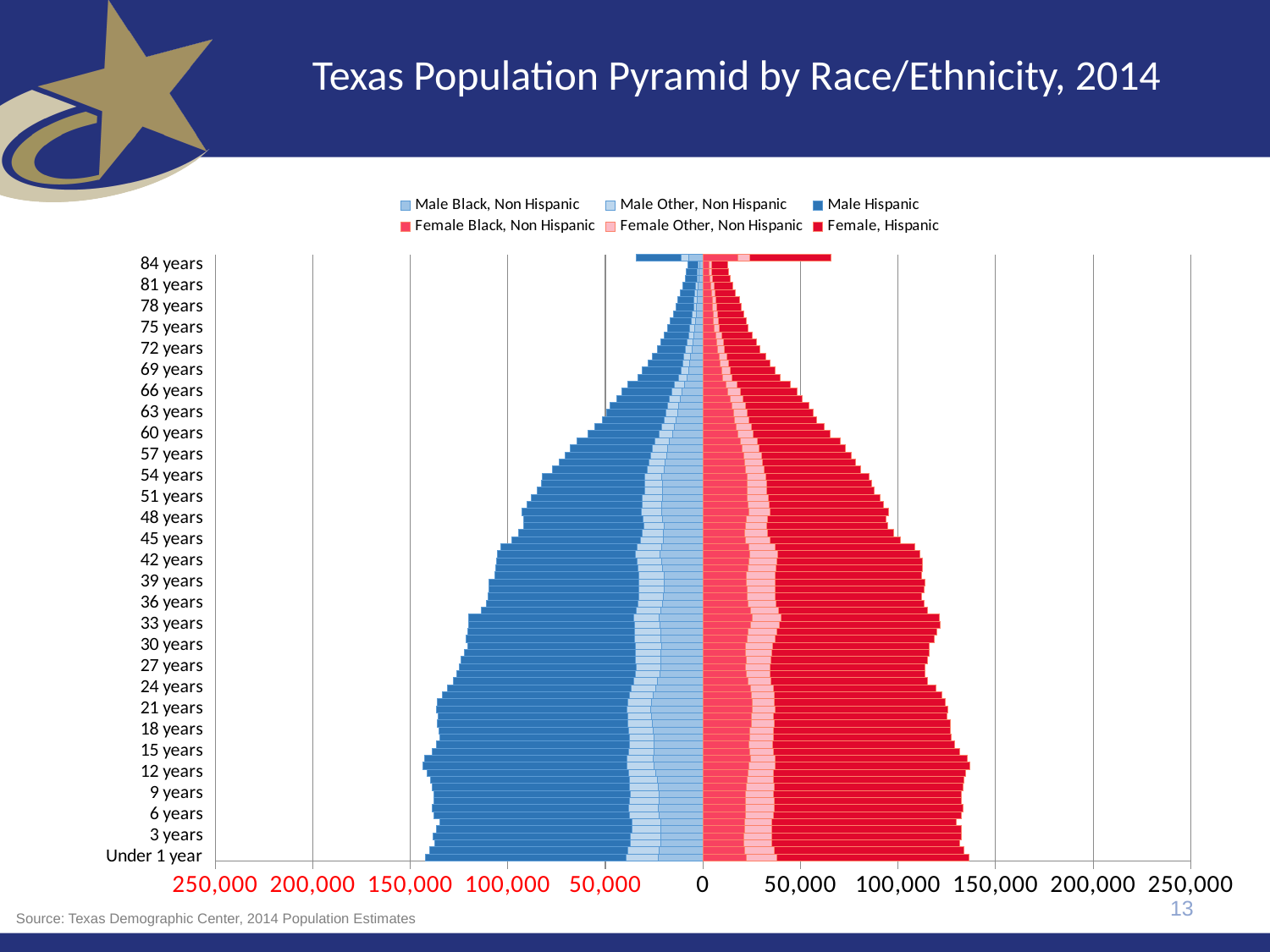
Do the bars generally get longer or shorter as age increases from Under 1 year to 84 years? Shorter Is the total male bar for Under 1 year greater or less than 100,000? greater Is the total male bar for 84 years greater or less than 50,000? less What kind of chart is shown on the slide? Bar chart (population pyramid) At 84 years, which is larger: the total male bar or the total female bar? Female How many series does the legend list? 6 Which legend entry is shown in dark blue? Male Hispanic Which is larger for males: the total bar for Under 1 year or the total bar for 84 years? Under 1 year What is the highest value shown on the horizontal axis? 250,000 What is the title of the chart? Texas Population Pyramid by Race/Ethnicity, 2014 Is the total female bar for 12 years greater or less than 100,000? greater